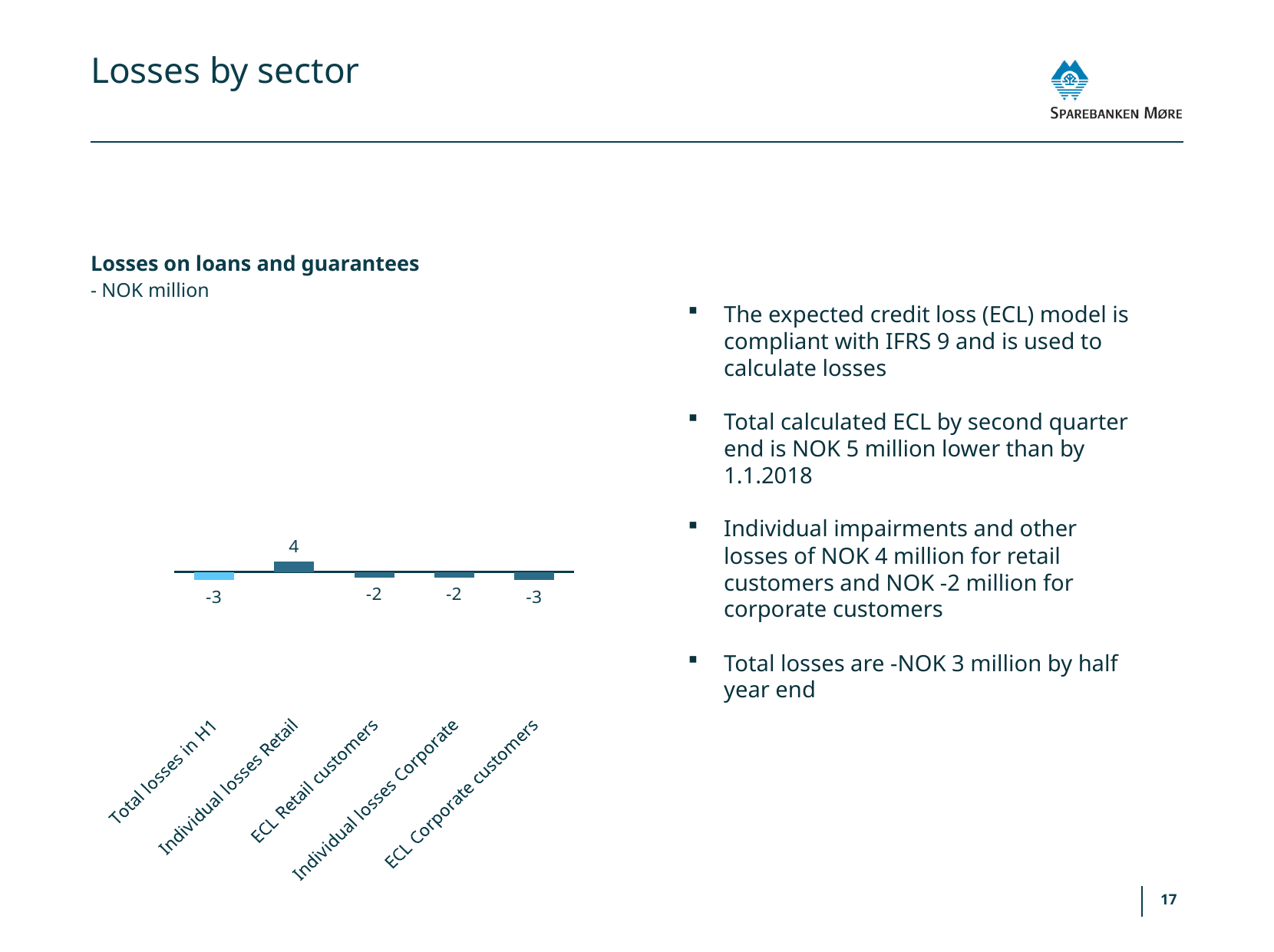
What is the value for Individual losses Retail? 4 How many categories are shown in the chart? 5 What is the title of the chart? Losses on loans and guarantees What is the value for ECL Retail customers? -2 Which is larger, the value for ECL Retail customers or the value for ECL Corporate customers? ECL Retail customers What is the value for Individual losses Corporate? -2 What kind of chart is shown on the slide? Bar chart What is the difference between the values for Individual losses Retail and Individual losses Corporate? 6 What is the value for ECL Corporate customers? -3 What is the value for Total losses in H1? -3 In what unit are the chart values expressed? NOK million Which category has the highest value? Individual losses Retail